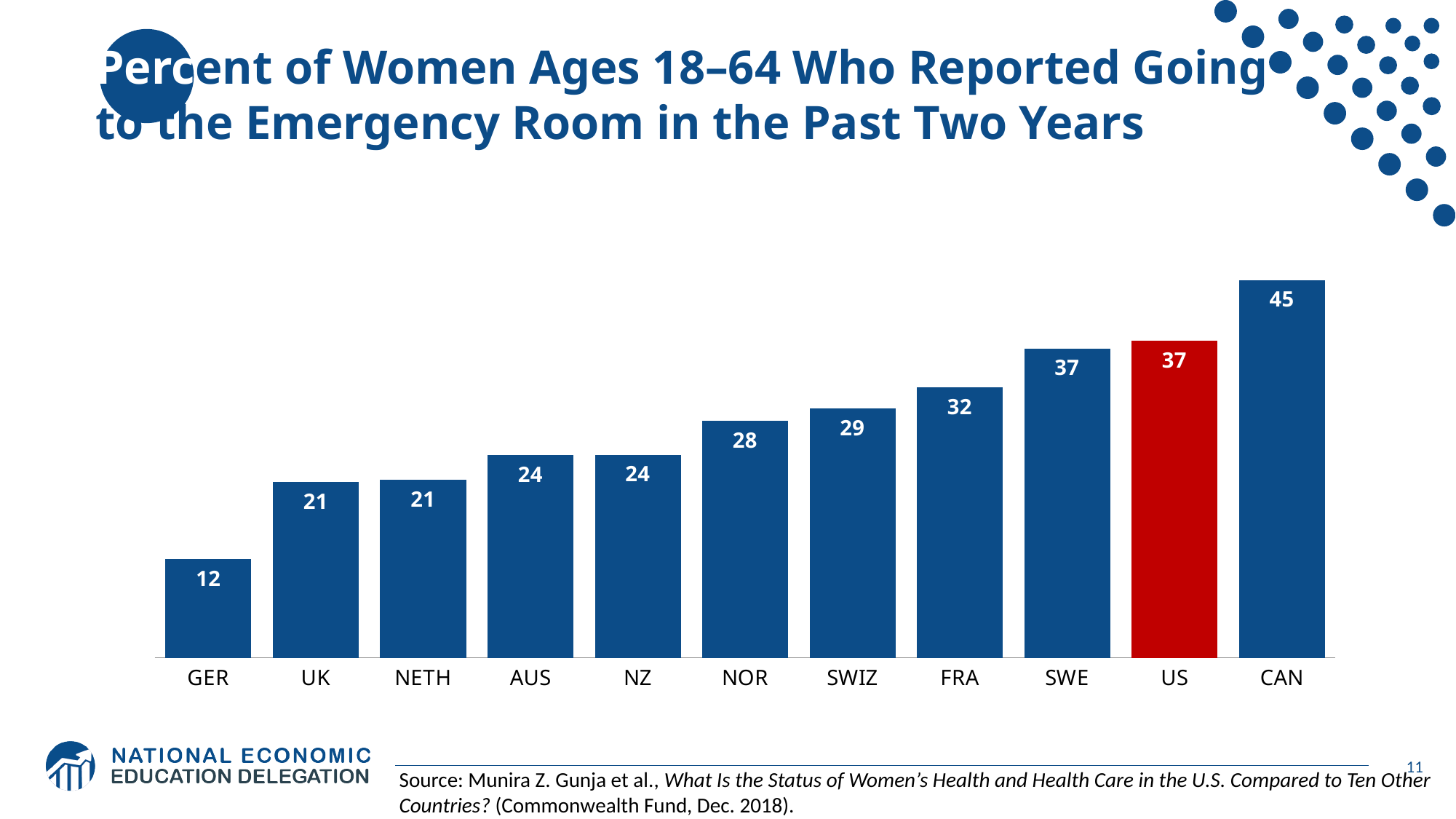
Which country's bar is coloured red? US Which country has the highest value? CAN What kind of chart is shown on the slide? Bar chart What is the difference between the values for FRA and GER? 20 Do the values generally rise or fall from left to right across the countries? Rise What is the difference between the values for CAN and the US? 8 What is the value for the US? 37 What is the value for GER? 12 How many countries are shown in the chart? 11 What is the value for NOR? 28 Which is larger, the value for SWIZ or the value for AUS? SWIZ Which country has the lowest value? GER